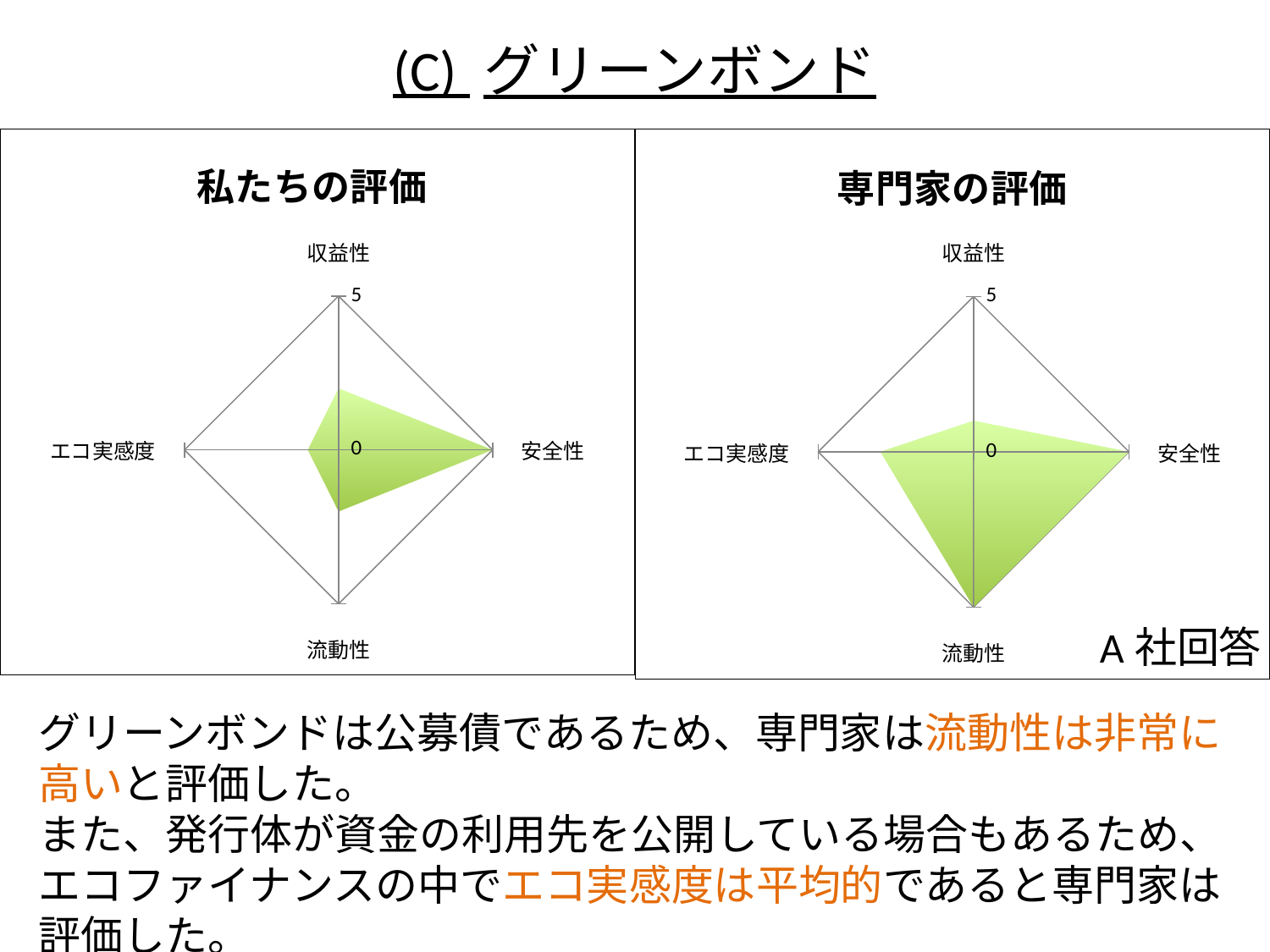
What is the maximum value shown on the axis scale of the "私たちの評価" radar chart? 5 In the "私たちの評価" chart, which category has the highest value? 安全性 What is the title of the chart on the right side of the slide? 専門家の評価 In the "専門家の評価" chart, which category has the lowest value? 収益性 In the "専門家の評価" chart, which is larger, the value for エコ実感度 or the value for 収益性? エコ実感度 How many axes (categories) does the "専門家の評価" radar chart have? 4 In the "私たちの評価" chart, which category has the lowest value? エコ実感度 In the "私たちの評価" chart, what is the value for 安全性? 5 In the "専門家の評価" chart, what is the value for 流動性? 5 What kind of chart is the "私たちの評価" chart? Radar chart In the "専門家の評価" chart, what is the value for 安全性? 5 In the "私たちの評価" chart, which is larger, the value for 安全性 or the value for 流動性? 安全性